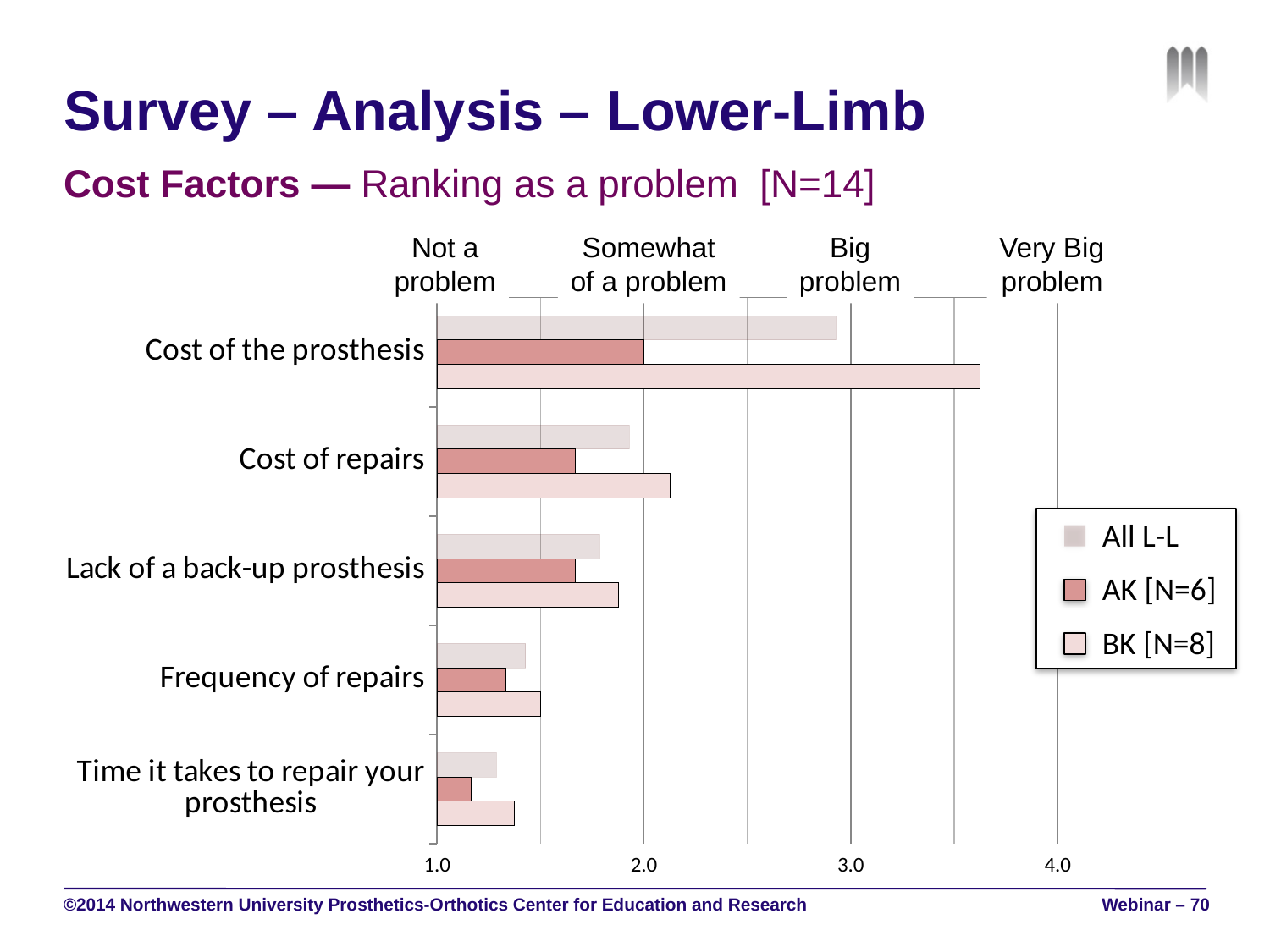
For Cost of the prosthesis, which series has the larger value, AK [N=6] or BK [N=8]? BK [N=8] Is the AK [N=6] value for Frequency of repairs greater or less than 2.0? less How many cost factor categories are plotted on the chart? 5 Is the All L-L value for Cost of the prosthesis greater or less than 3.0? less Which category has the lowest value for the AK [N=6] series? Time it takes to repair your prosthesis For the All L-L series, which is larger: Cost of repairs or Frequency of repairs? Cost of repairs Is the BK [N=8] value for Cost of repairs greater or less than 2.0? greater What kind of chart is shown on the slide? bar chart How many series does the legend list? 3 Which category has the highest value for the BK [N=8] series? Cost of the prosthesis What are the three entries listed in the chart legend? All L-L, AK [N=6], BK [N=8]